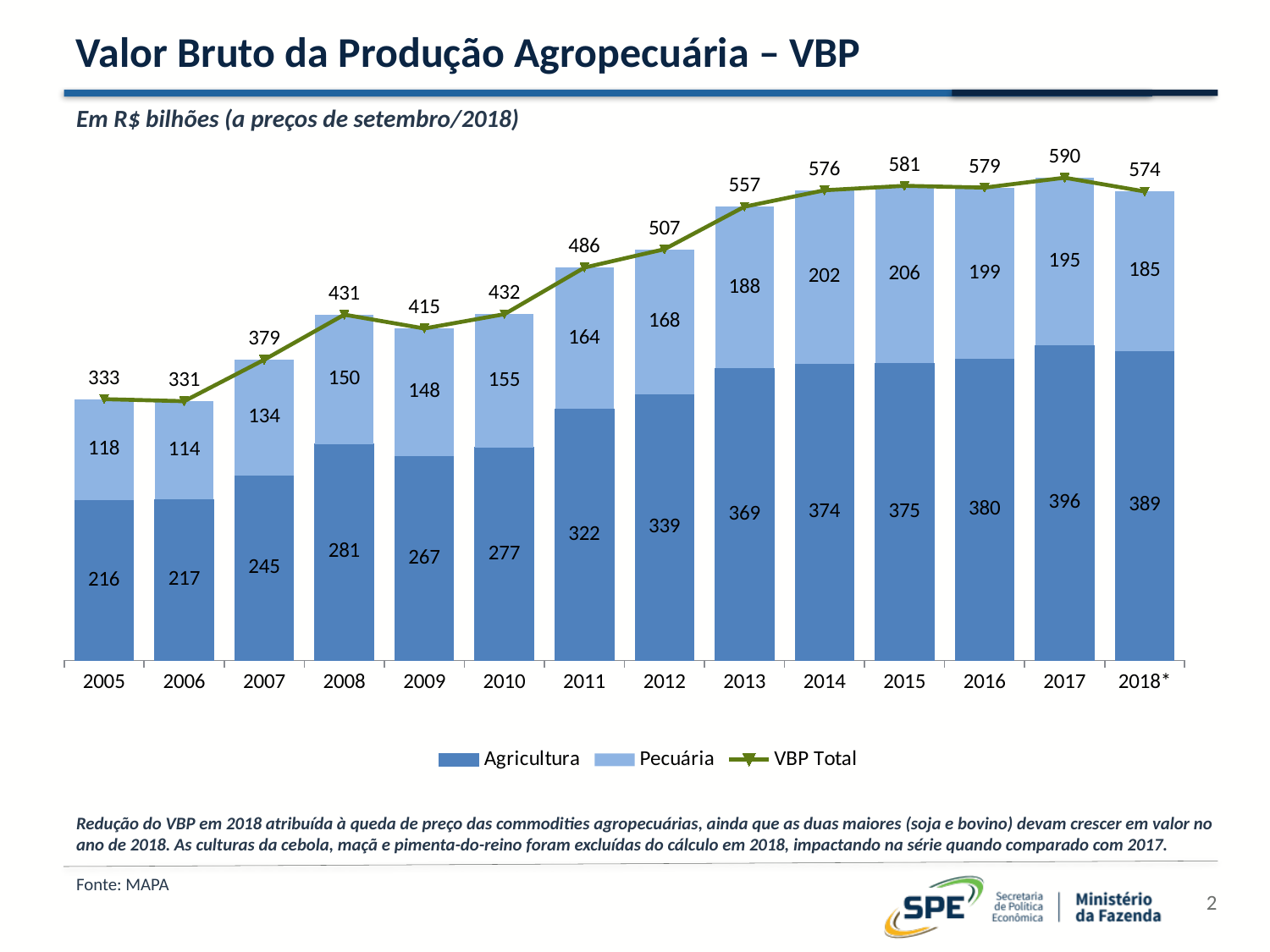
What is the source cited for the chart? MAPA What is the Pecuária value for 2015? 206 Which is larger, the Pecuária value for 2014 or for 2016? 2014 Does the Agricultura value rise or fall from 2005 to 2017? Rise How many years are shown on the x axis? 14 What is the Agricultura value for 2011? 322 In which year is the VBP Total highest? 2017 What is the difference between the Agricultura values for 2017 and 2018*? 7 What is the VBP Total value for 2018*? 574 What kind of chart is this? Stacked bar chart with a line In which year is the Pecuária value lowest? 2006 How many series does the legend list? 3